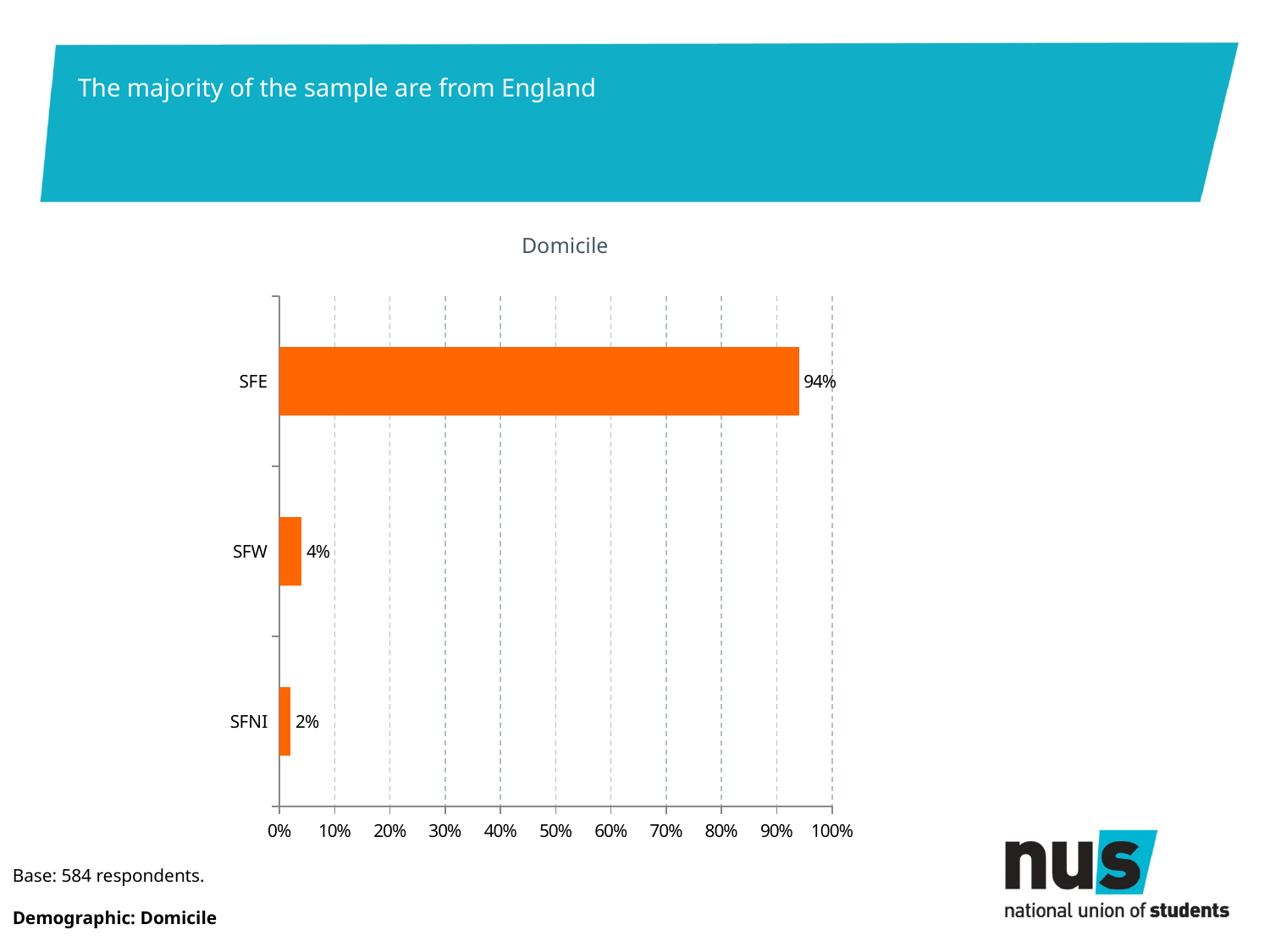
What is the title of the chart? Domicile How many categories are shown in the chart? 3 Which category has the highest value? SFE What kind of chart is shown on the slide? bar chart What is the value for SFW? 4% What is the value for SFNI? 2% Which category has the lowest value? SFNI Is the value for SFE greater or less than 90%? greater What is the difference between the values for SFE and SFW? 90% What is the difference between the values for SFW and SFNI? 2% What is the value for SFE? 94% Which is larger, the value for SFW or the value for SFNI? SFW